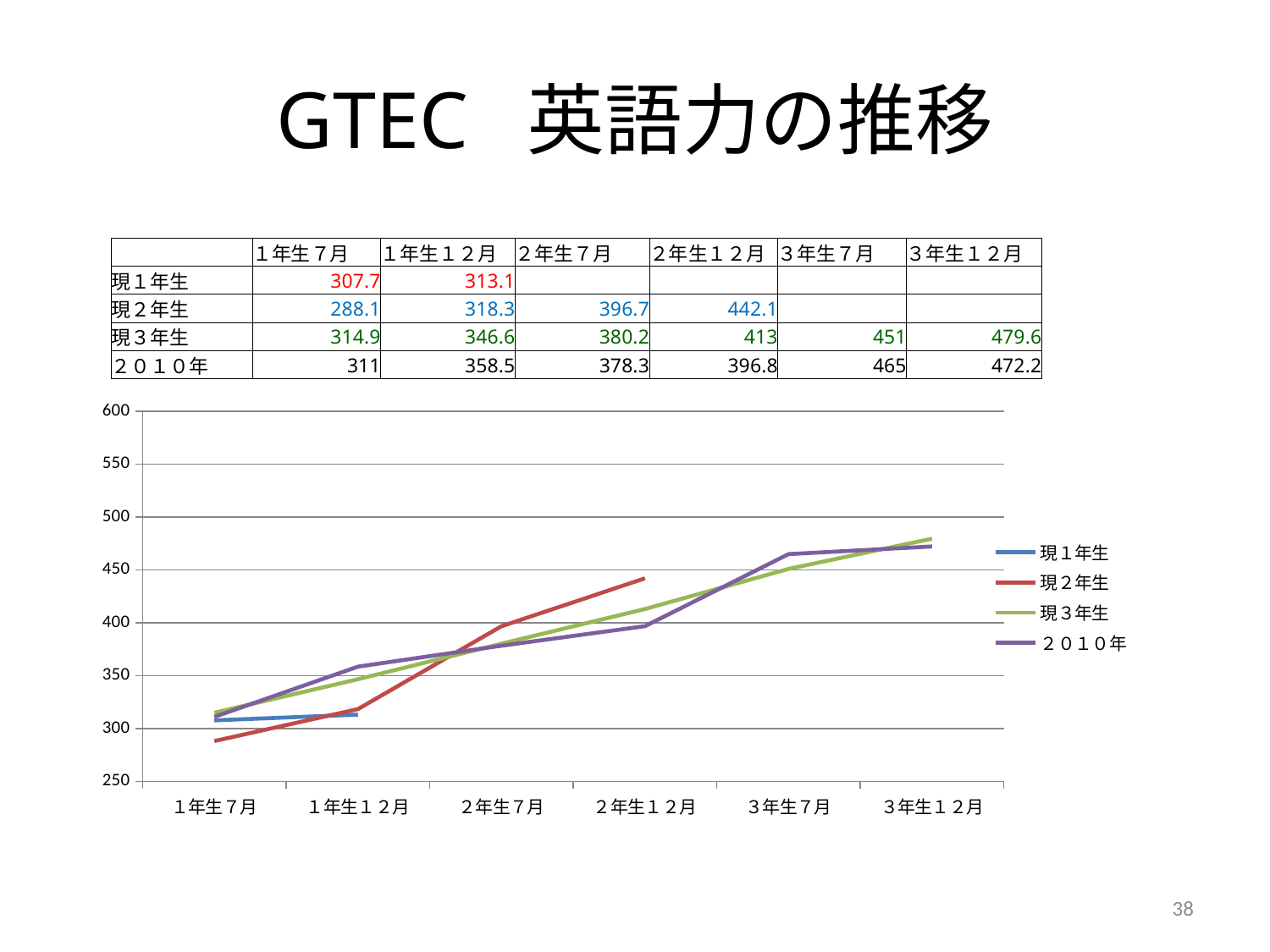
What type of chart is shown on the slide? line chart Which is larger at ２年生１２月: 現２年生 or ２０１０年? 現２年生 What is the title of the slide containing the chart? GTEC 英語力の推移 Which series has the lowest value at １年生７月? 現２年生 How many categories are shown on the x axis of the chart? 6 Does the 現３年生 series rise or fall from １年生７月 to ３年生１２月? rise What is the value for ２０１０年 at ３年生７月? 465 What is the value for 現３年生 at ３年生１２月? 479.6 What is the value for 現２年生 at ２年生１２月? 442.1 What is the value for 現１年生 at １年生７月? 307.7 How many series does the chart legend list? 4 What is the difference between 現３年生 and ２０１０年 at ３年生１２月? 7.4